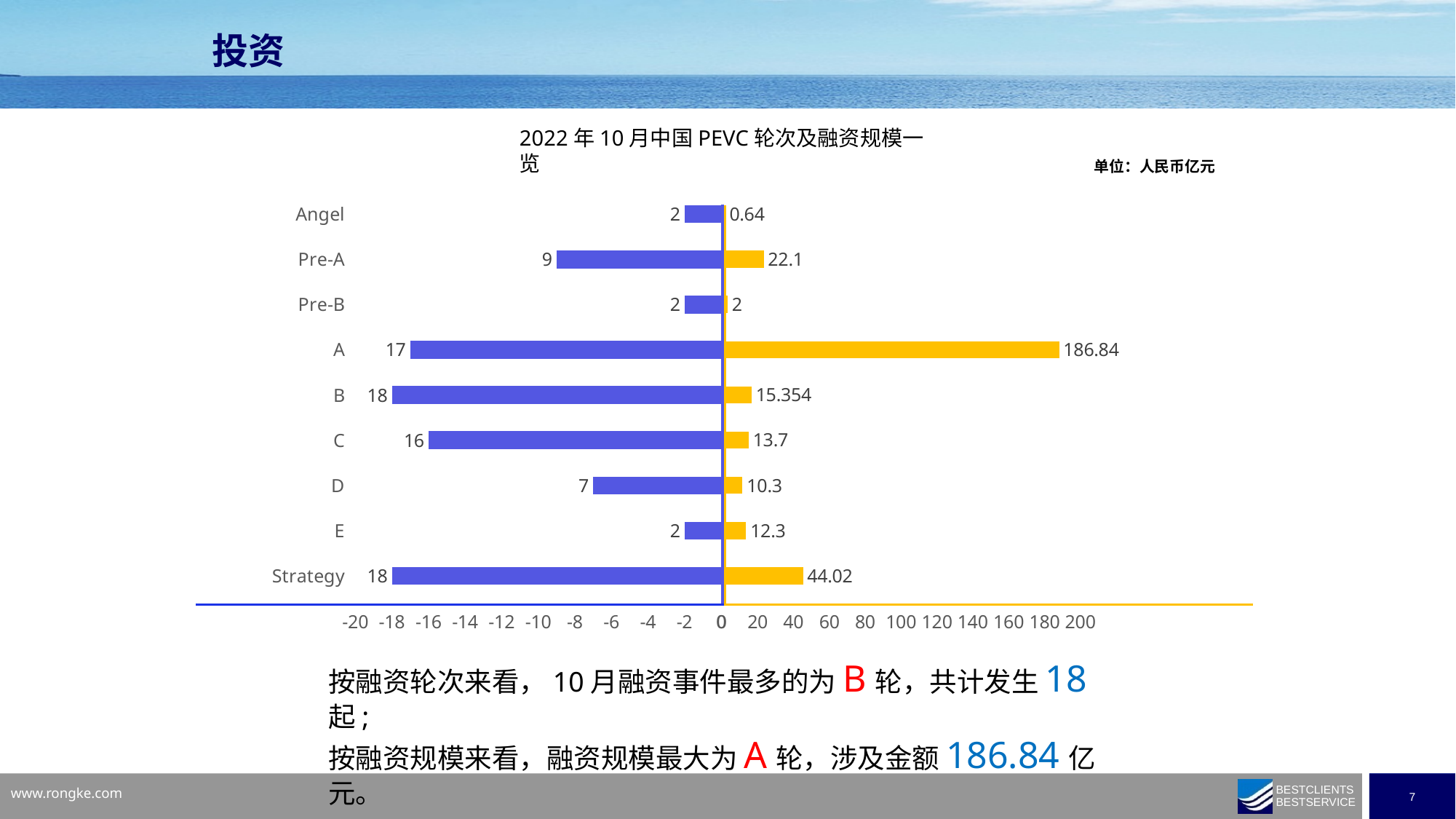
Which round has the largest financing amount (yellow bar)? A How many financing rounds (categories) are listed on the chart? 9 What is the financing amount (yellow bar) for round A? 186.84 What is the number of financing events (blue bar) for round B? 18 What is the difference in the number of financing events between round A (17) and round D (7)? 10 What is the difference in financing amount between round A (186.84) and the Strategy round (44.02)? 142.82 What type of chart is shown on the slide? bar chart Which has more financing events (blue bar): round C or round D? C Which round has the smallest financing amount (yellow bar)? Angel What is the financing amount (yellow bar) for the Strategy round? 44.02 What unit is stated for the financing amounts on the chart? 人民币亿元 What is the number of financing events (blue bar) for Pre-A? 9